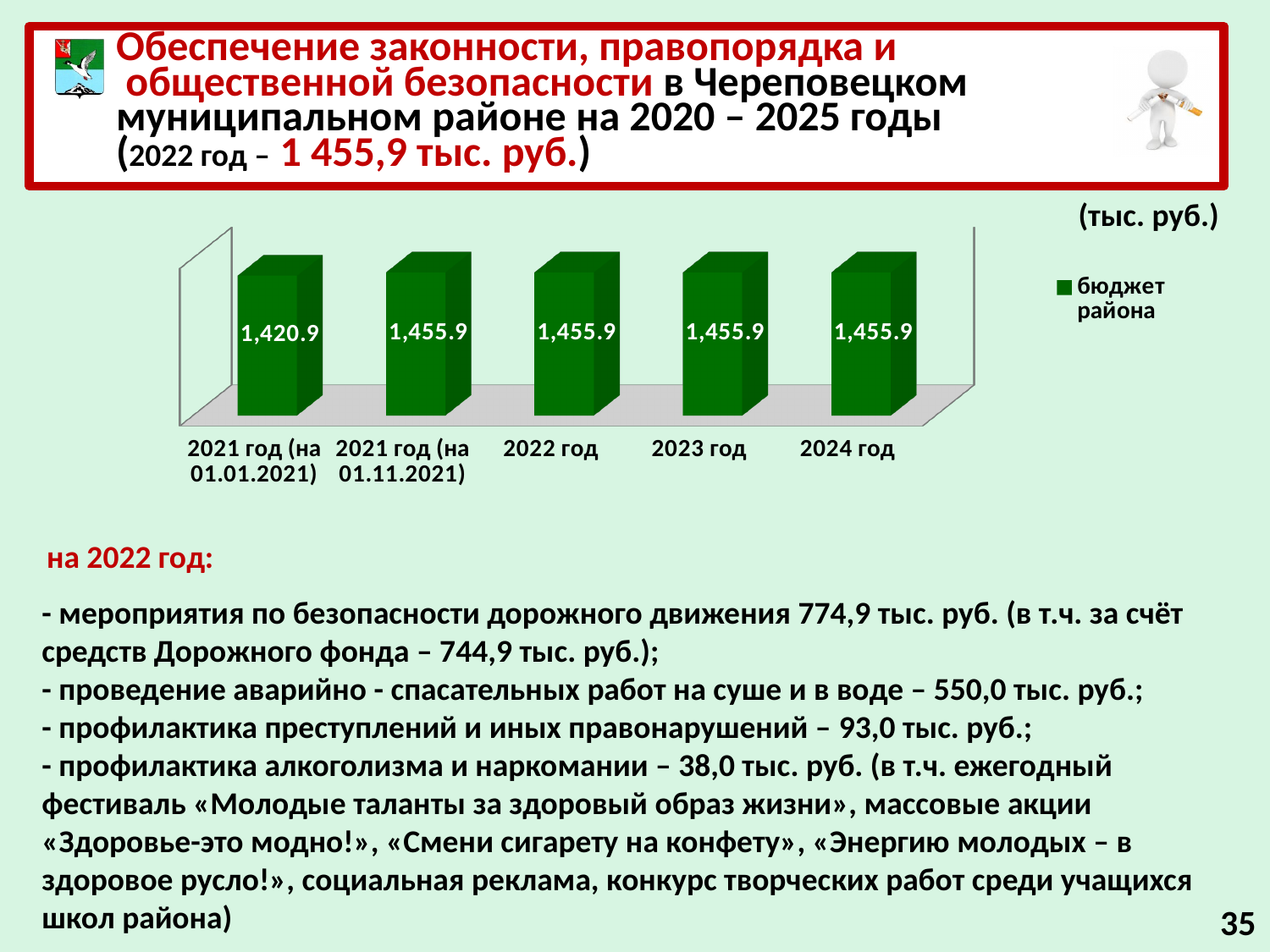
Which is larger: the value for 2021 год (на 01.01.2021) or the value for 2023 год? 2023 год Do the values rise or fall from 2021 год (на 01.01.2021) to 2021 год (на 01.11.2021)? rise What kind of chart is shown on the slide? bar chart How many categories are shown on the x axis of the chart? 5 What unit is indicated for the chart's values? тыс. руб. What is the name of the series listed in the chart's legend? бюджет района What is the difference between the values for 2021 год (на 01.11.2021) and 2021 год (на 01.01.2021)? 35.0 What is the value for 2021 год (на 01.01.2021) in the chart? 1,420.9 What is the value for 2022 год in the chart? 1,455.9 What is the value for 2024 год in the chart? 1,455.9 Which category has the lowest value in the chart? 2021 год (на 01.01.2021) How many series does the chart's legend list? 1